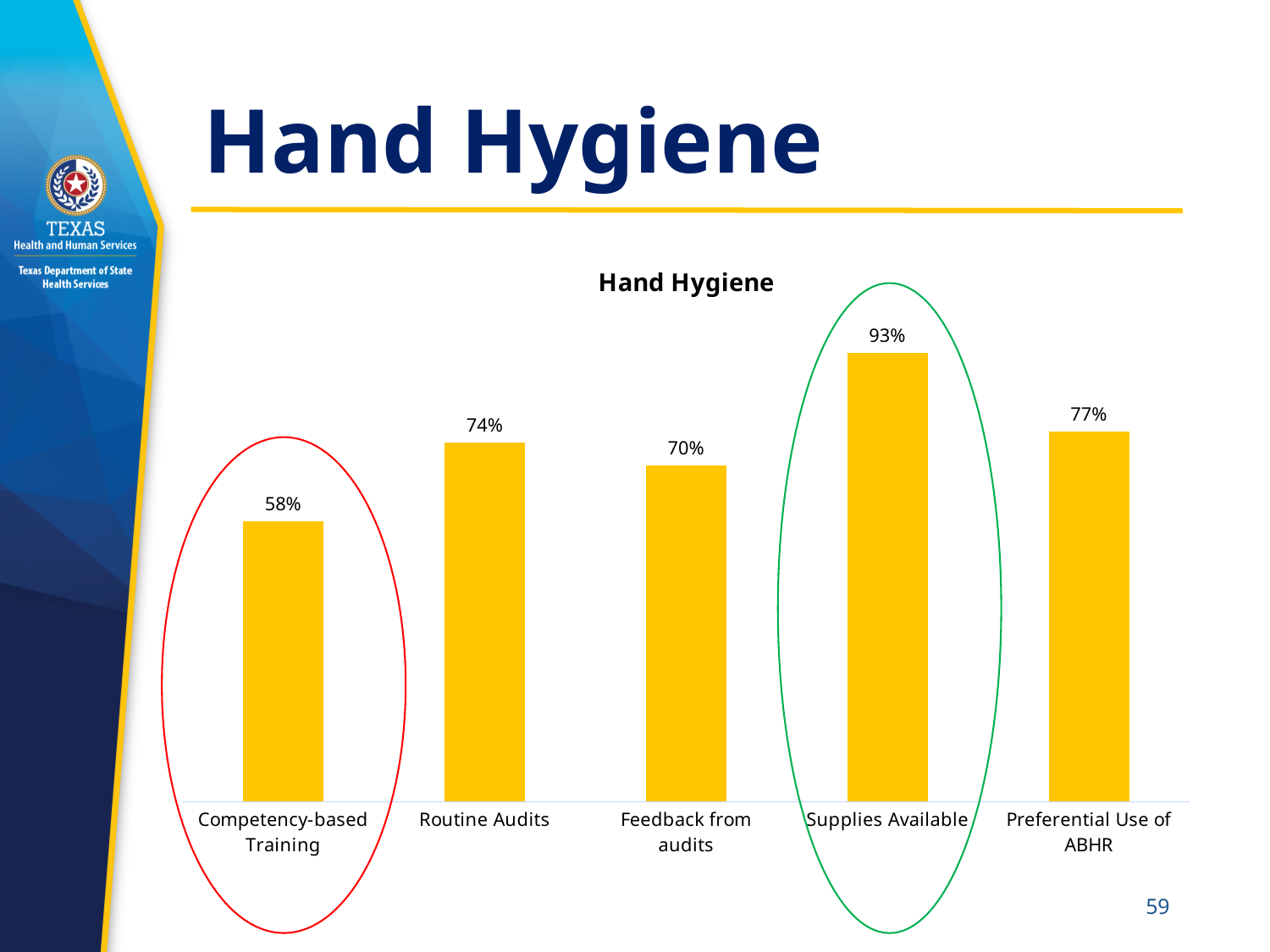
What is the value for Preferential Use of ABHR? 77% What is the value for Feedback from audits? 70% Which category has the lowest value? Competency-based Training What is the value for Supplies Available? 93% What is the difference between Routine Audits and Feedback from audits? 4% What is the value for Competency-based Training? 58% What kind of chart is shown on the slide? Bar chart What is the difference between Supplies Available and Competency-based Training? 35% Which is larger, Routine Audits or Preferential Use of ABHR? Preferential Use of ABHR What is the title of the chart? Hand Hygiene Which category has the highest value? Supplies Available How many categories are shown in the chart? 5